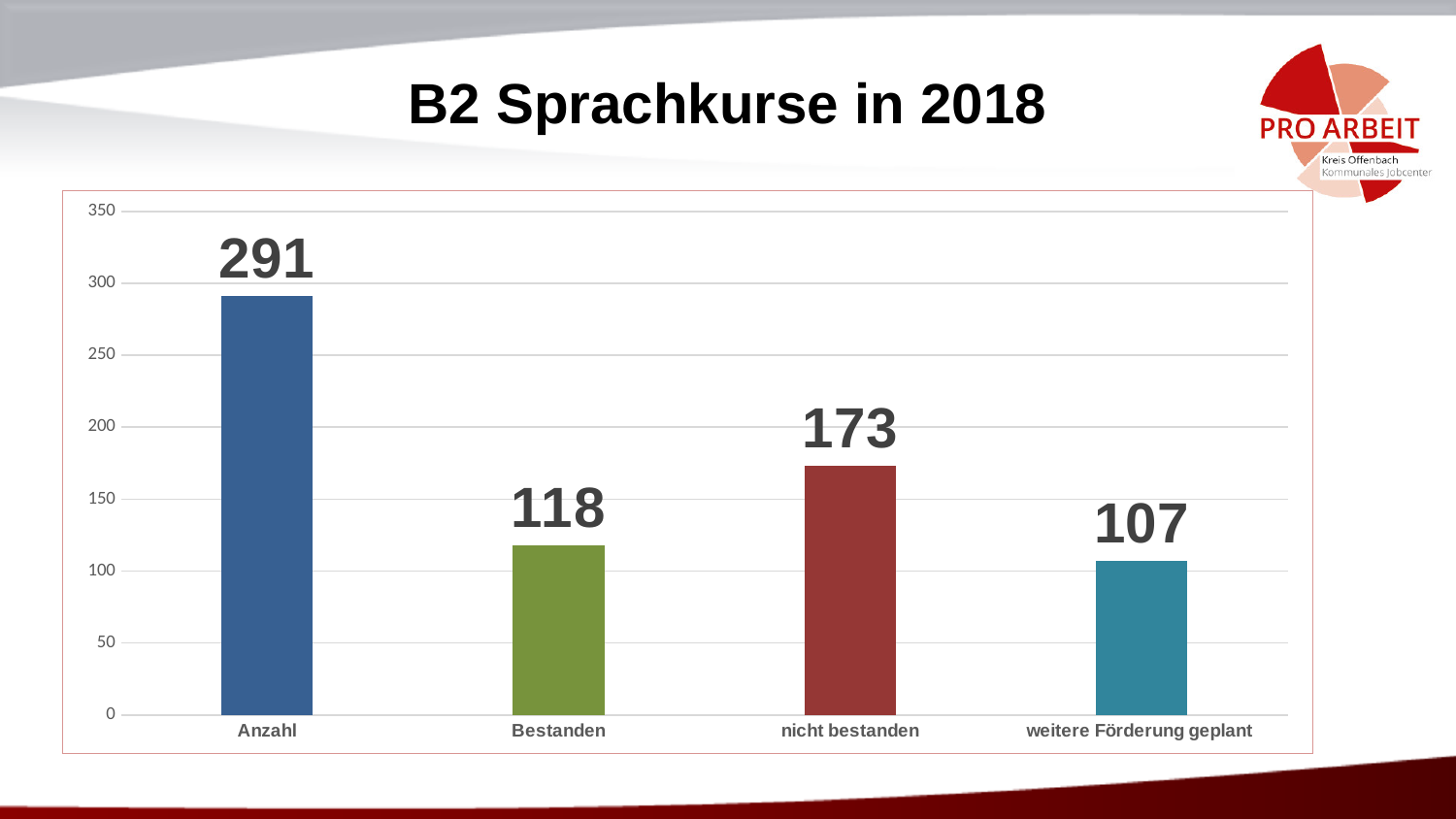
How many categories are shown on the x axis? 4 What is the value for weitere Förderung geplant? 107 What is the difference between the values for Anzahl and Bestanden? 173 What is the difference between the values for nicht bestanden and Bestanden? 55 What is the value for Bestanden? 118 Is the value for nicht bestanden greater or less than 150? greater Which is larger, the value for Bestanden or the value for nicht bestanden? nicht bestanden What kind of chart is shown on the slide? bar chart What is the value for Anzahl? 291 What is the value for nicht bestanden? 173 Which category has the highest value? Anzahl Which category has the lowest value? weitere Förderung geplant